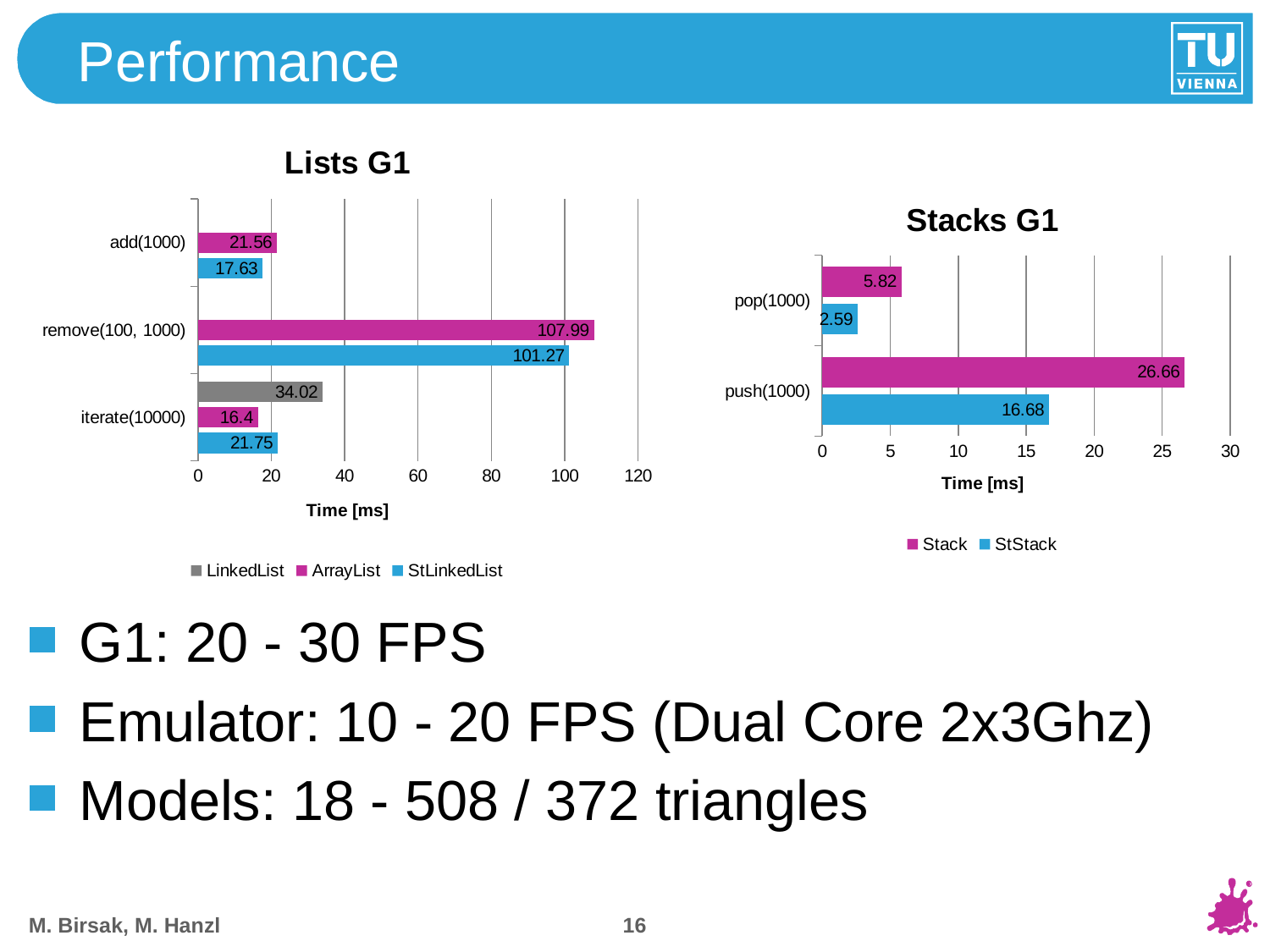
In the Stacks G1 chart, what is the StStack value for pop(1000)? 2.59 In the Lists G1 chart, what is the LinkedList value for iterate(10000)? 34.02 In the Lists G1 chart, which category has the highest ArrayList value? remove(100, 1000) In the Lists G1 chart, which is larger for iterate(10000): ArrayList or StLinkedList? StLinkedList In the Lists G1 chart, what is the StLinkedList value for add(1000)? 17.63 In the Lists G1 chart, how many series does the legend list? 3 In the Stacks G1 chart, what is the Stack value for push(1000)? 26.66 What kind of chart is the Stacks G1 chart? Bar chart In the Lists G1 chart, what is the ArrayList value for remove(100, 1000)? 107.99 In the Stacks G1 chart, what is the difference between the Stack and StStack values for push(1000)? 9.98 In the Stacks G1 chart, how many categories are shown? 2 In the Lists G1 chart, what is the difference between the ArrayList and StLinkedList values for remove(100, 1000)? 6.72